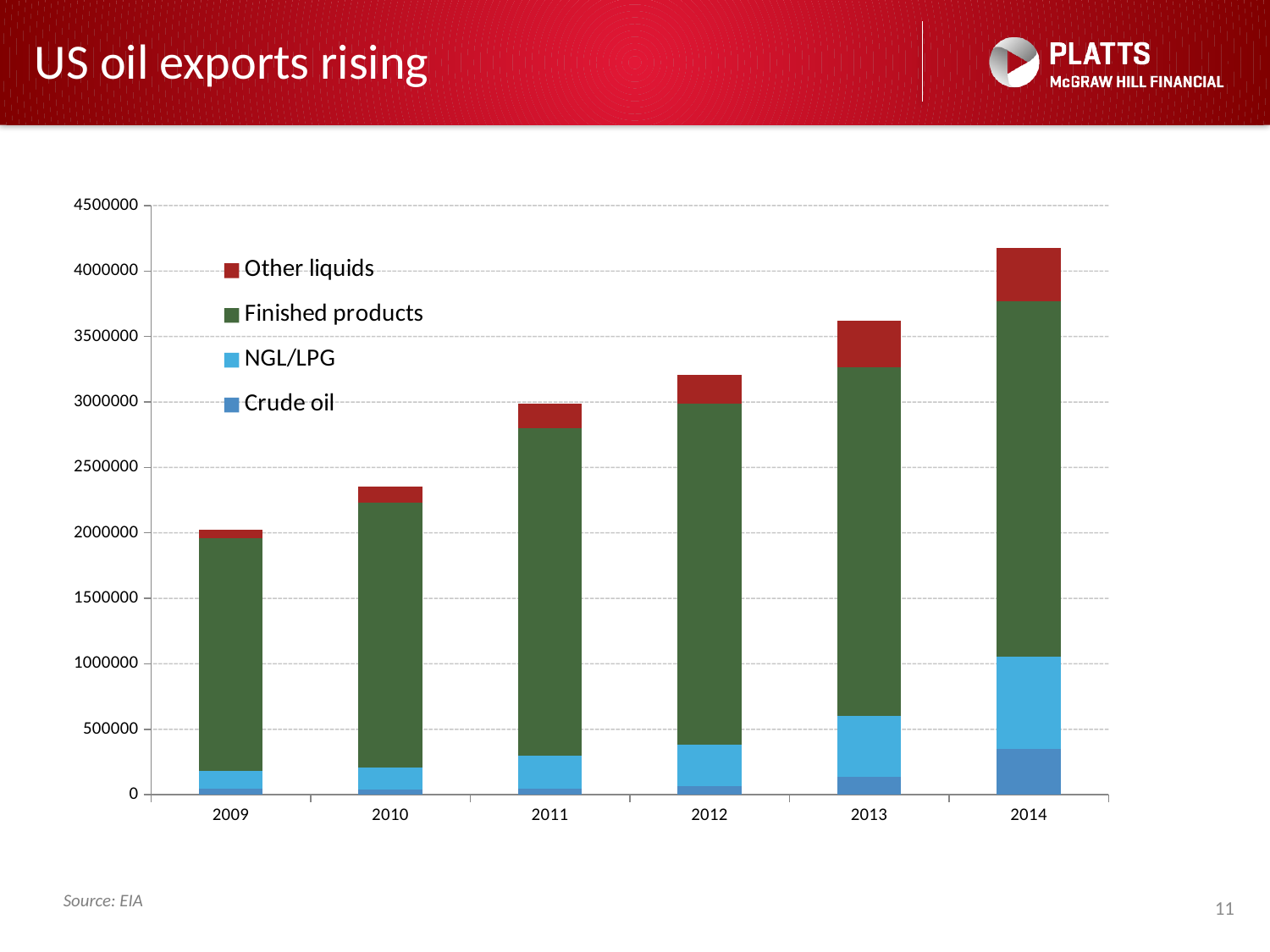
Which series in the chart's legend is shown in dark green? Finished products Which year has the tallest stacked bar in the chart? 2014 Which year has the shortest stacked bar in the chart? 2009 How many years are shown on the x axis of the chart? 6 What kind of chart is shown on the slide? Stacked bar chart Is the total stacked bar for 2010 greater or less than 2500000? less How many series does the chart's legend list? 4 Is the total stacked bar for 2013 greater or less than 3500000? greater Is the total stacked bar for 2014 greater or less than 4000000? greater Which year has the larger total stacked bar, 2012 or 2013? 2013 Do the total stacked bar heights rise or fall from 2009 to 2014? Rise What is the title of the slide containing the chart? US oil exports rising